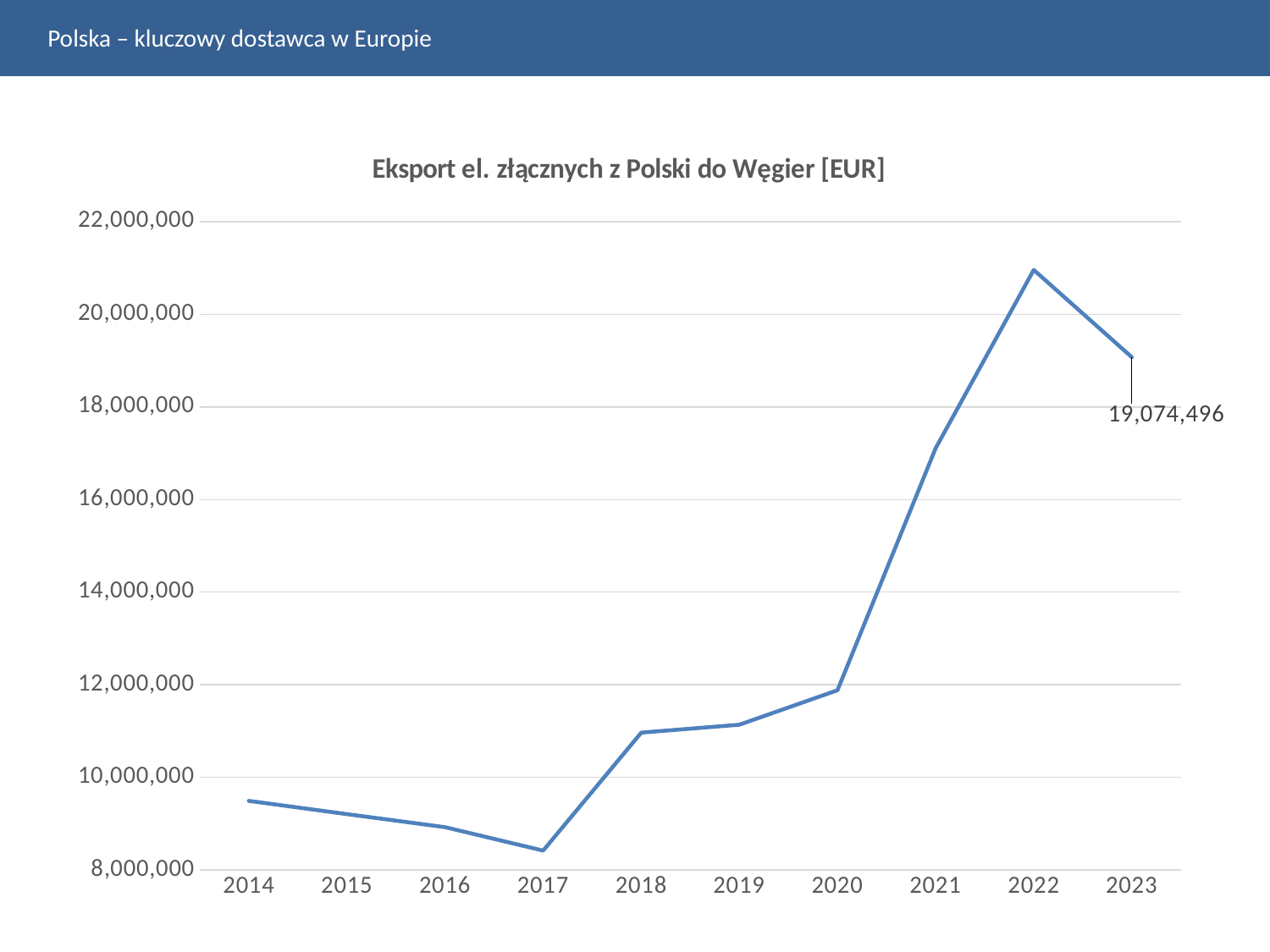
Is the value for 2020 greater or less than 12,000,000? less What is the title of the chart? Eksport el. złącznych z Polski do Węgier [EUR] Is the value for 2022 greater or less than 20,000,000? greater Is the value for 2017 greater or less than 10,000,000? less What kind of chart is shown? line chart Which year has the highest value? 2022 Which is larger, the value for 2018 or the value for 2016? 2018 What is the value for 2023? 19,074,496 Which is larger, the value for 2022 or the value for 2023? 2022 Which year has the lowest value? 2017 How many years are plotted on the x axis? 10